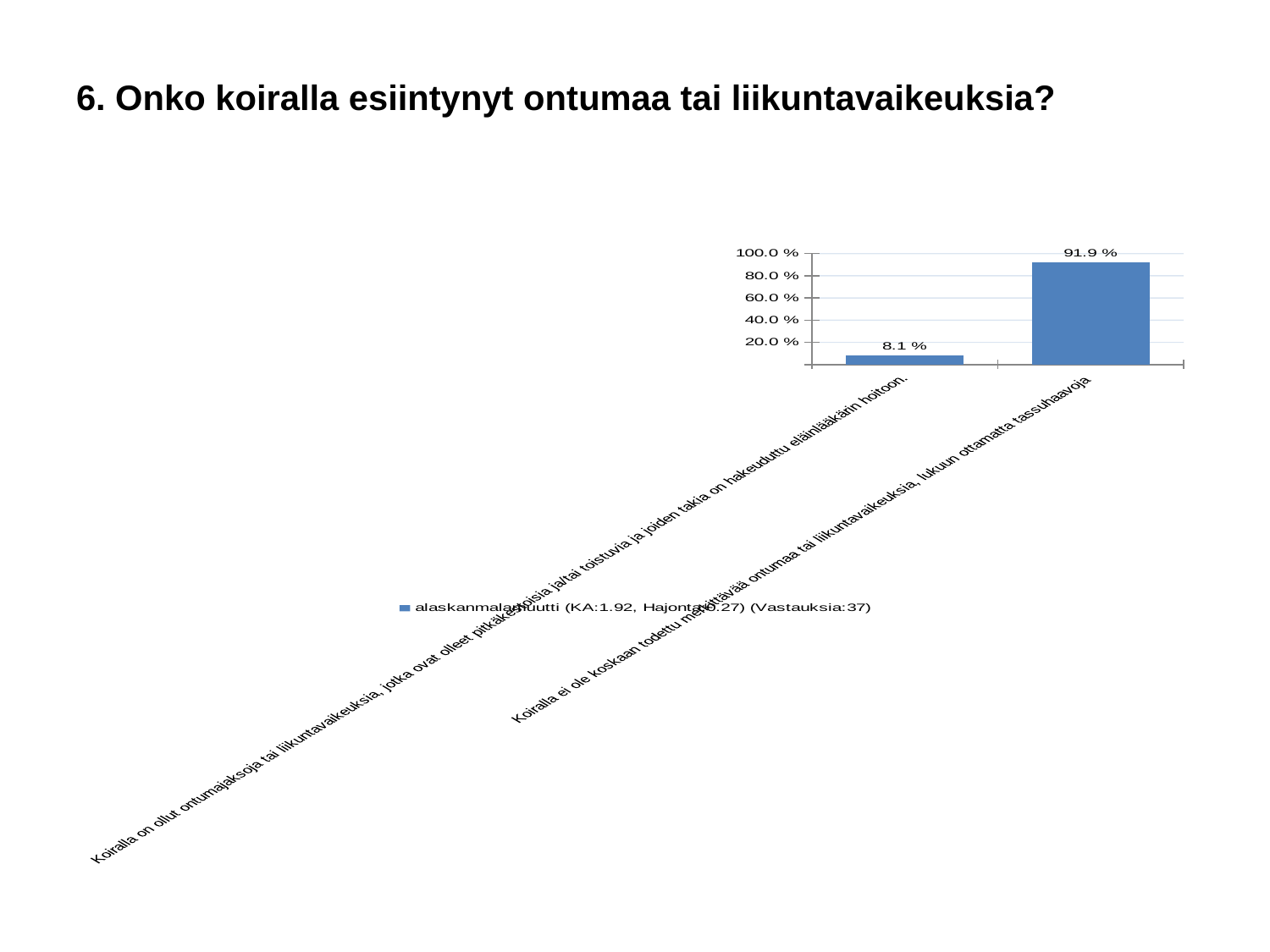
What is the difference between the two bar values (91.9 % and 8.1 %)? 83.8 % How many series does the legend list? 1 Which category has the lowest value? Koiralla on ollut ontumajaksoja tai liikuntavaikeuksia, jotka ovat olleet pitkäkestoisia ja/tai toistuvia ja joiden takia on hakeuduttu eläinlääkärin hoitoon. What is the value for the category "Koiralla ei ole koskaan todettu merkittävää ontumaa tai liikuntavaikeuksia, lukuun ottamatta tassuhaavoja"? 91.9 % What type of chart is shown on the slide? bar chart Is the value for the "Koiralla on ollut ontumajaksoja..." category greater or less than 20.0 %? less How many bars (categories) does the chart show? 2 What is the value for the category stating the dog has had prolonged and/or recurring lameness episodes requiring veterinary care ("Koiralla on ollut ontumajaksoja...")? 8.1 % Which category has the highest value? Koiralla ei ole koskaan todettu merkittävää ontumaa tai liikuntavaikeuksia, lukuun ottamatta tassuhaavoja How many responses (Vastauksia) does the legend entry report? 37 What is the title of the slide above the chart? 6. Onko koiralla esiintynyt ontumaa tai liikuntavaikeuksia? Is the value for the "Koiralla ei ole koskaan todettu..." category greater or less than 80.0 %? greater